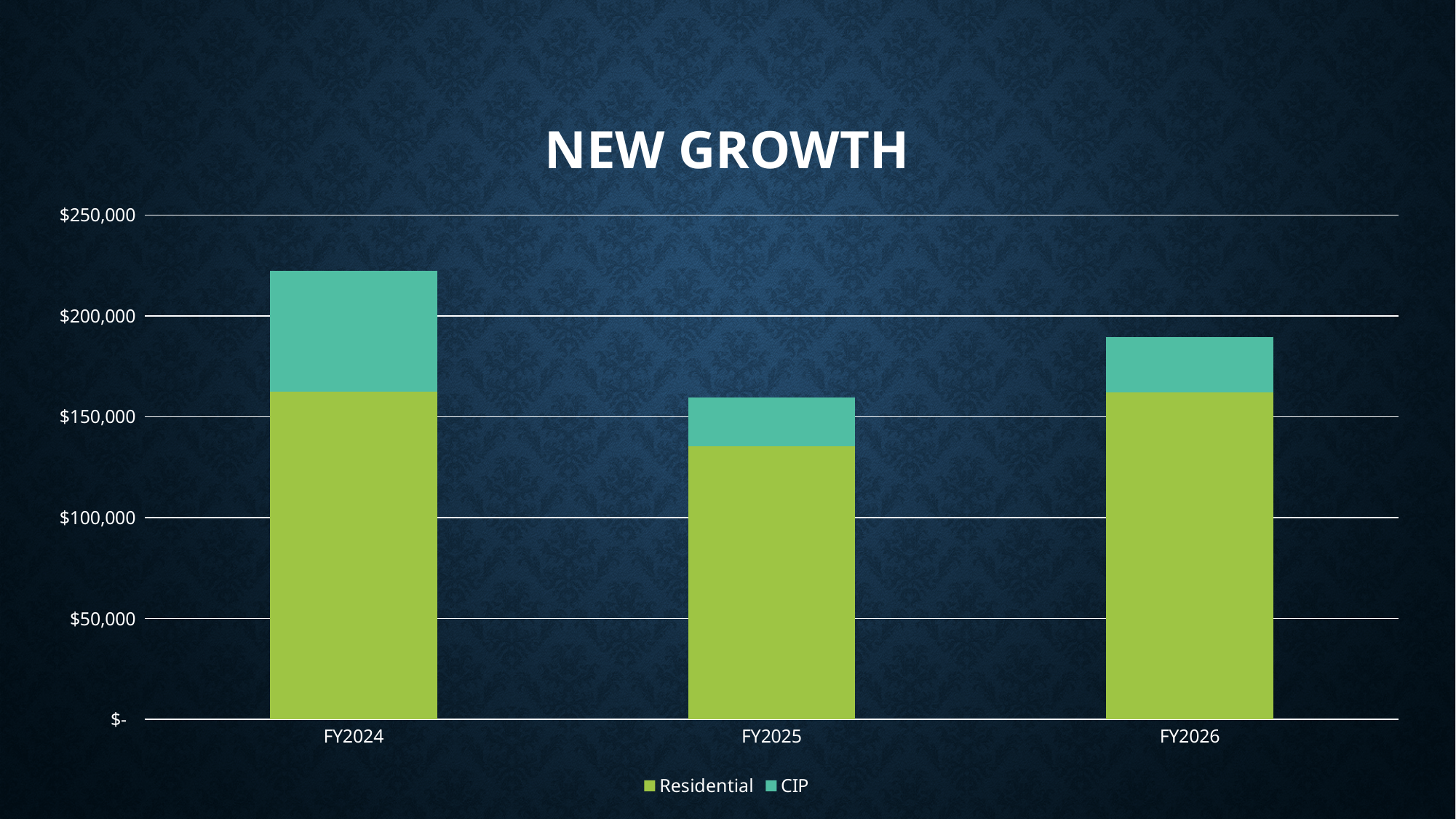
What kind of chart is shown on the slide? Stacked bar chart How many series does the legend list? 2 Does the total bar rise or fall from FY2024 to FY2025? fall Which fiscal year has the lowest total bar? FY2025 Which fiscal year has the highest total bar? FY2024 Which fiscal year has the largest CIP segment? FY2024 What is the title of the chart? NEW GROWTH Is the total value for FY2024 greater or less than $200,000? greater Is the total value for FY2026 greater or less than $200,000? less Which is larger, the total for FY2025 or the total for FY2026? FY2026 How many fiscal years are shown on the x axis? 3 Is the Residential value for FY2025 greater or less than $150,000? less